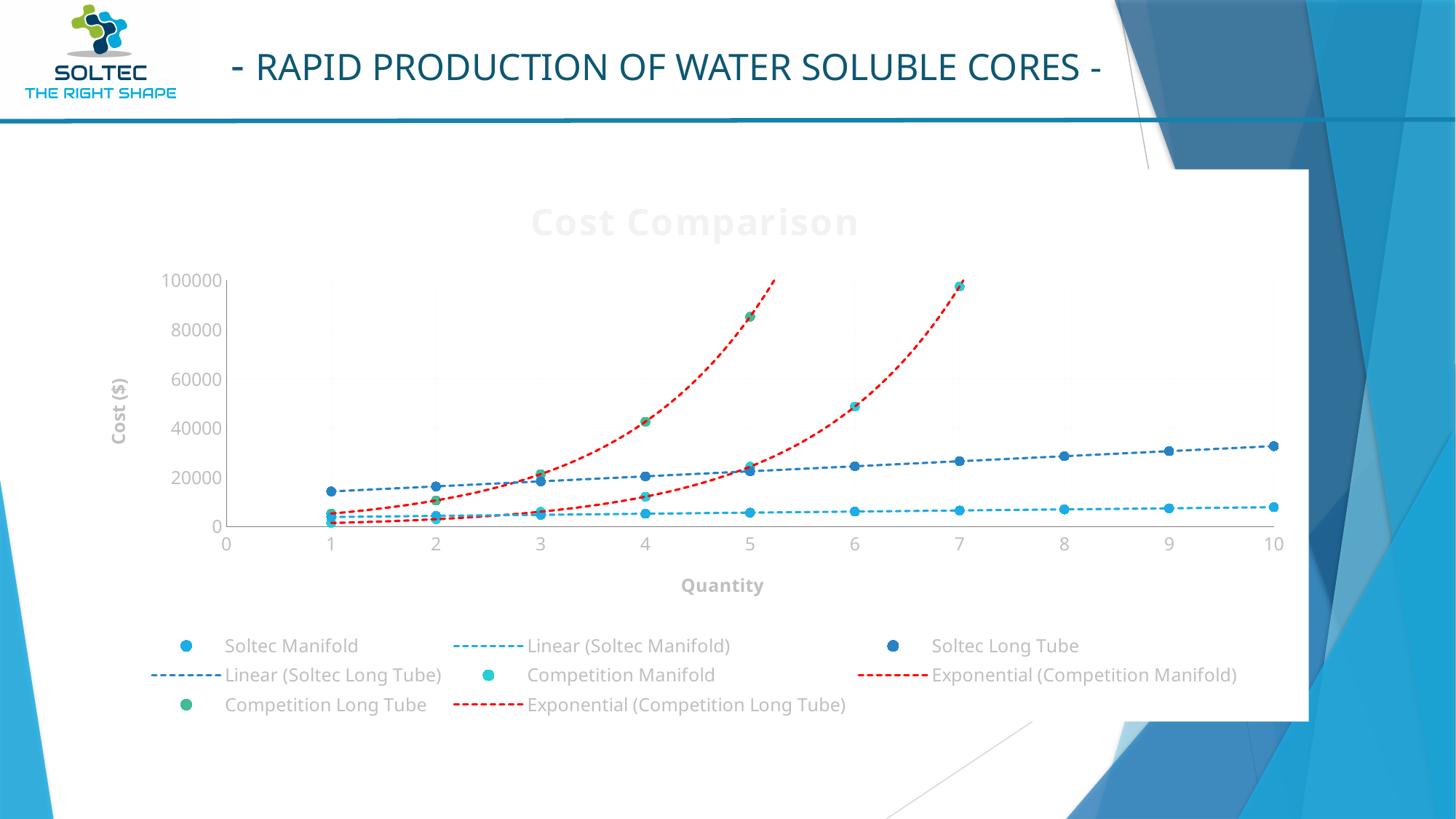
How many entries does the chart's legend list? 8 Do the Soltec Long Tube values rise or fall as quantity increases? rise How many data points are plotted for Soltec Long Tube? 10 How many data points are plotted for Competition Long Tube? 5 Is the value for Competition Long Tube at quantity 5 greater or less than 80000? greater What kind of chart is shown on the slide? scatter chart What is the label of the vertical axis? Cost ($) At quantity 7, which is larger: Competition Manifold or Soltec Long Tube? Competition Manifold What is the title of the chart? Cost Comparison Is the value for Soltec Manifold at quantity 10 greater or less than 20000? less Is the value for Competition Manifold at quantity 6 greater or less than 40000? greater